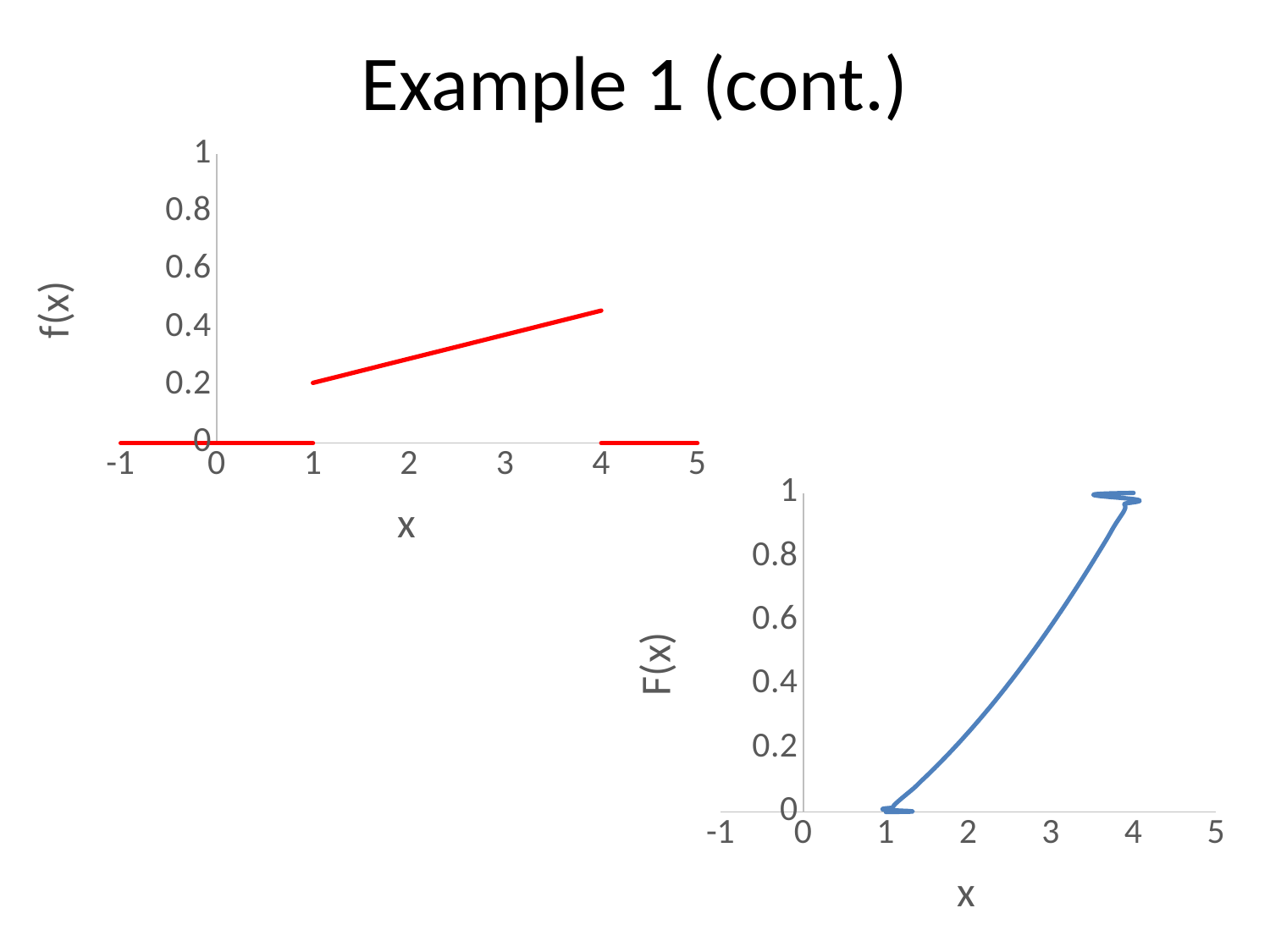
In the top-left chart, what is the value of f(x) at x = 0? 0 In the top-left chart, is the value of f(x) at x = 3 greater or less than 0.6? less In the top-left chart, does f(x) rise or fall between x = 1 and x = 4? rise What kind of chart is the bottom-right chart with the y axis labelled F(x)? line chart In the top-left chart, what is the label on the y axis? f(x) In the bottom-right chart, what is the value of F(x) at x = 1? 0 In the bottom-right chart, is the value of F(x) at x = 3 greater or less than 0.4? greater In the top-left chart, what is the value of f(x) at x = 5? 0 What kind of chart is the top-left chart with the y axis labelled f(x)? line chart In the bottom-right chart, does F(x) rise or fall as x increases from 1 to 4? rise In the bottom-right chart, what is the label on the y axis? F(x) In the top-left chart, is the value of f(x) at x = 3 greater or less than 0.2? greater